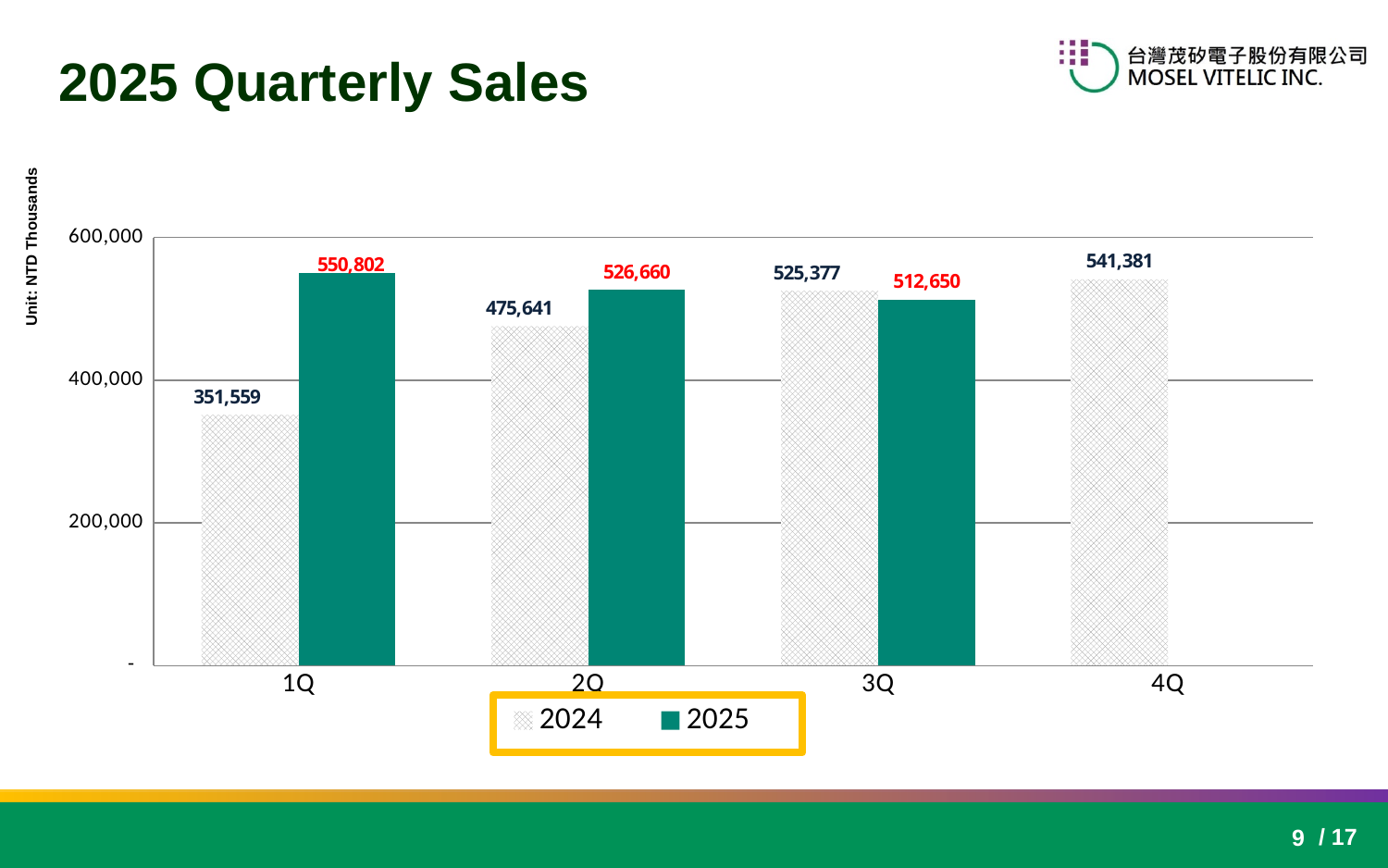
Which quarter has the lowest 2024 sales? 1Q Which quarter has the highest 2025 sales? 1Q What is the difference between 2025 and 2024 sales in 1Q? 199,243 What is the 2025 sales value for 2Q? 526,660 How many quarters are shown on the x axis? 4 What is the 2024 sales value for 1Q? 351,559 In 3Q, which is larger, the 2024 value or the 2025 value? 2024 Do the 2025 sales values rise or fall from 1Q to 3Q? fall Which quarter has the lowest 2025 sales? 3Q What is the 2024 sales value for 4Q? 541,381 What is the difference between 2024 and 2025 sales in 3Q? 12,727 How many series does the legend list? 2